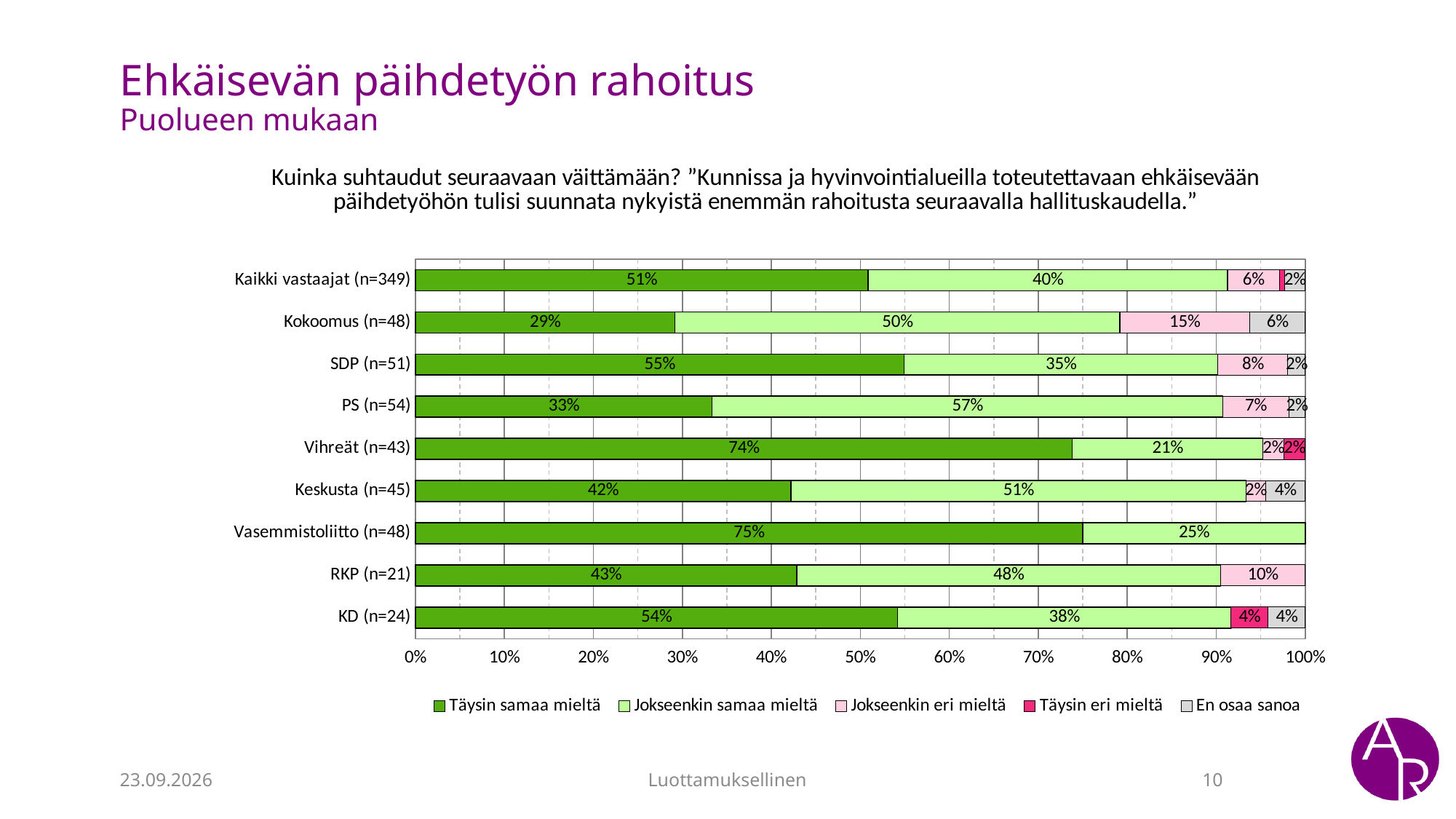
What share of RKP respondents answered "Jokseenkin eri mieltä"? 10% What is the combined share of "Täysin samaa mieltä" and "Jokseenkin samaa mieltä" for Vasemmistoliitto? 100% What is the "Täysin samaa mieltä" value for Kaikki vastaajat (n=349)? 51% Which group has the highest "Jokseenkin eri mieltä" share? Kokoomus (n=48) What is the "Jokseenkin samaa mieltä" value for PS (n=54)? 57% How many percentage points higher is the "Jokseenkin eri mieltä" share for Kokoomus than for SDP? 7 percentage points How many respondent groups (bars) are shown in the chart? 9 Which has a larger "Täysin samaa mieltä" share, SDP or PS? SDP How many series does the legend list? 5 What percentage of Kokoomus respondents answered "Täysin samaa mieltä"? 29% Which party has the lowest "Täysin samaa mieltä" share? Kokoomus (n=48) What type of chart is shown on the slide? Stacked bar chart